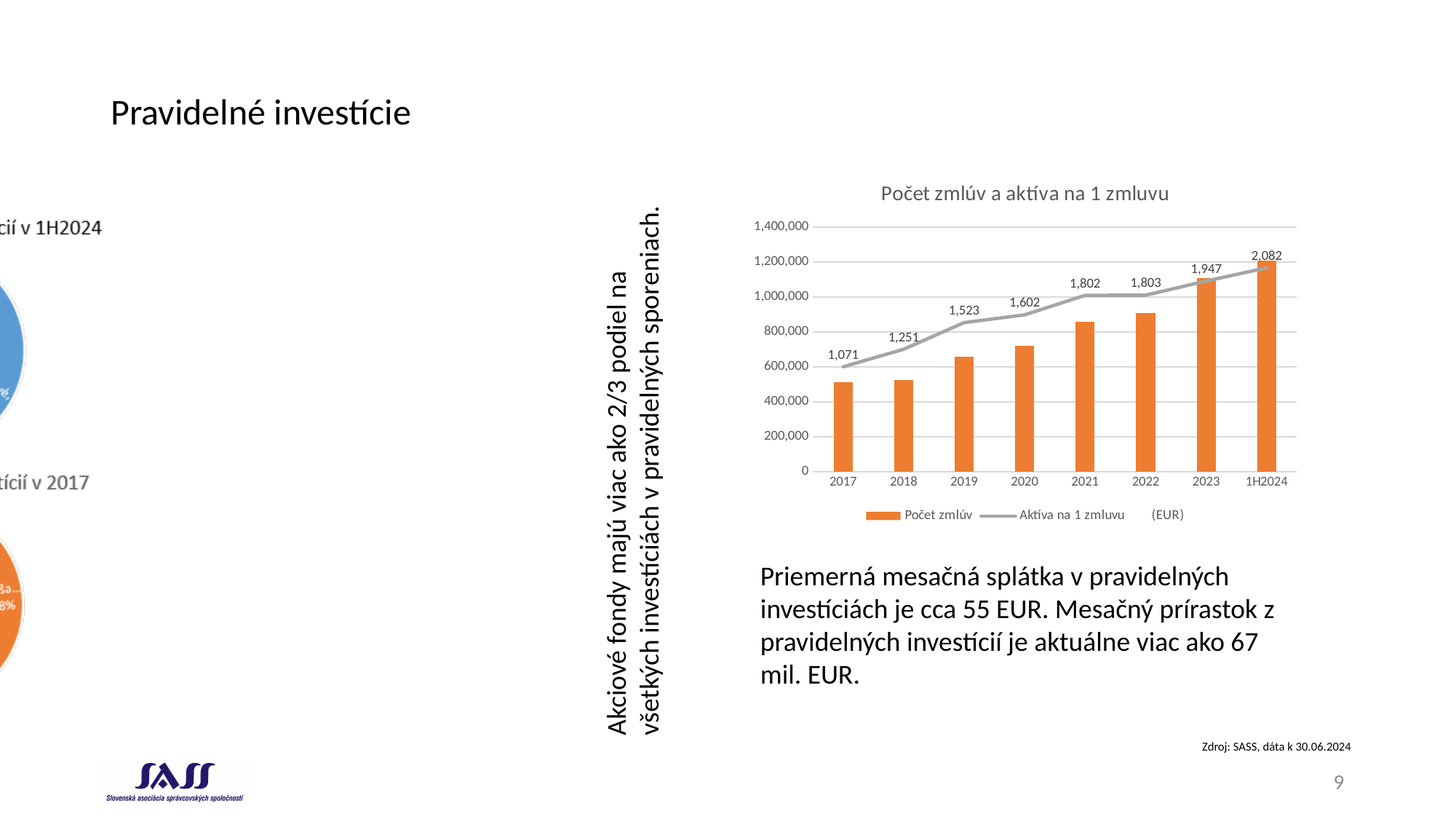
In the chart 'Počet zmlúv a aktíva na 1 zmluvu', what is the difference between Aktíva na 1 zmluvu in 1H2024 and in 2017? 1,011 In the chart 'Počet zmlúv a aktíva na 1 zmluvu', which year has the highest value of Aktíva na 1 zmluvu? 1H2024 In the chart 'Počet zmlúv a aktíva na 1 zmluvu', is the Počet zmlúv bar for 2017 greater or less than 600,000? less In the chart 'Počet zmlúv a aktíva na 1 zmluvu', how many series does the legend list? 2 In the chart 'Počet zmlúv a aktíva na 1 zmluvu', what is the difference between Aktíva na 1 zmluvu in 2023 and in 2022? 144 In the chart 'Počet zmlúv a aktíva na 1 zmluvu', is the Počet zmlúv bar for 2023 greater or less than 1,000,000? greater In the chart 'Počet zmlúv a aktíva na 1 zmluvu', what is the value of Aktíva na 1 zmluvu for 2017? 1,071 In the chart 'Počet zmlúv a aktíva na 1 zmluvu', what is the value of Aktíva na 1 zmluvu for 1H2024? 2,082 In the chart 'Počet zmlúv a aktíva na 1 zmluvu', how many time periods are shown on the x axis? 8 In the chart 'Počet zmlúv a aktíva na 1 zmluvu', what is the value of Aktíva na 1 zmluvu for 2020? 1,602 In the chart 'Počet zmlúv a aktíva na 1 zmluvu', does the Počet zmlúv series rise or fall from 2017 to 1H2024? rise In the chart 'Počet zmlúv a aktíva na 1 zmluvu', which year has the lowest value of Aktíva na 1 zmluvu? 2017